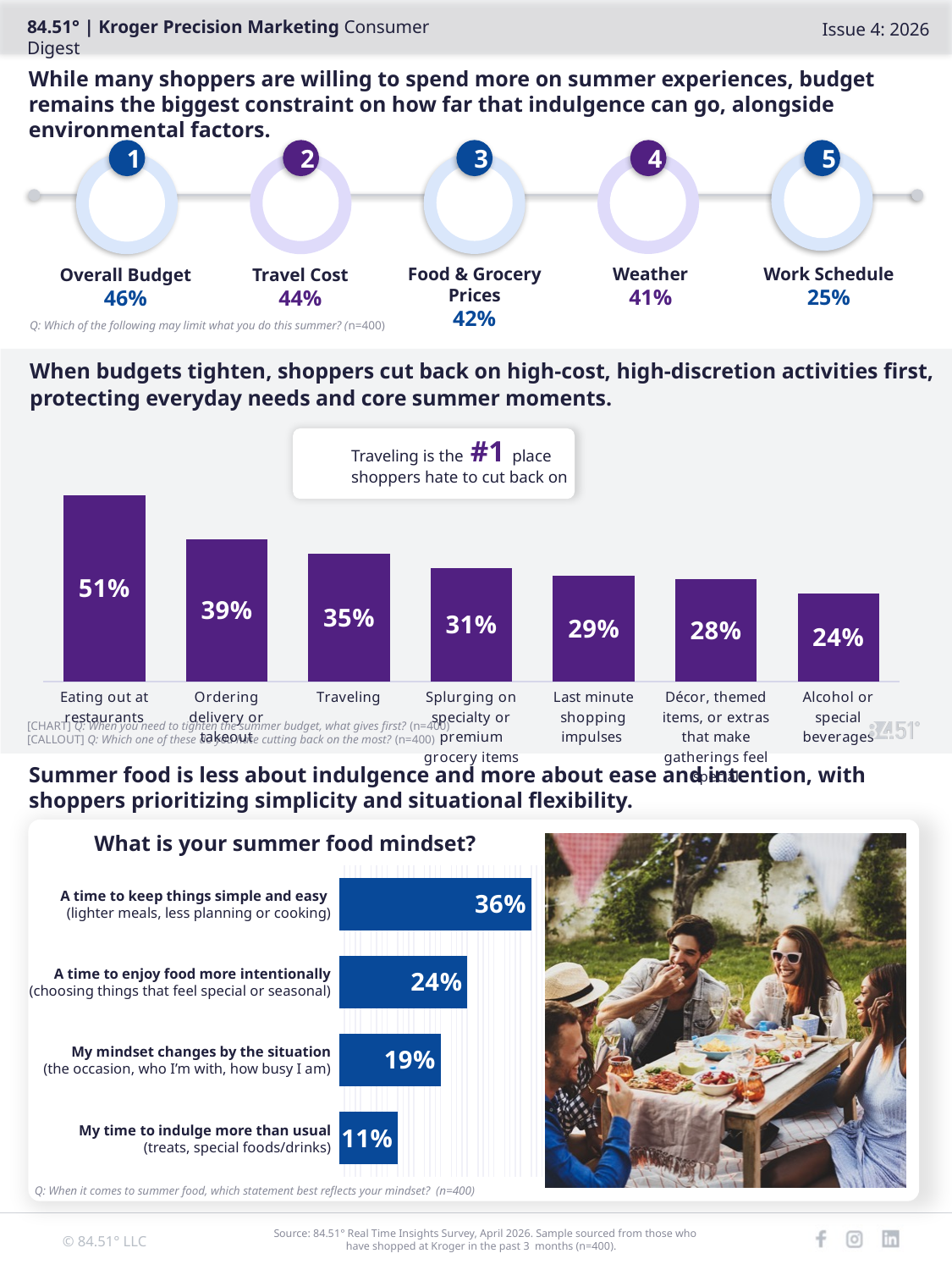
In the middle bar chart about what shoppers cut back on first, do the values rise or fall from left to right? Fall In the 'What is your summer food mindset?' chart, what is the value for 'A time to keep things simple and easy'? 36% In the middle bar chart about what shoppers cut back on first, how many categories are shown? 7 In the middle bar chart about what shoppers cut back on first, what is the value for Traveling? 35% What type of chart is the 'What is your summer food mindset?' chart? Bar chart In the middle bar chart about what shoppers cut back on first, which category has the lowest value? Alcohol or special beverages In the middle bar chart about what shoppers cut back on first, what is the value for Eating out at restaurants? 51% In the 'What is your summer food mindset?' chart, how many categories are shown? 4 In the middle bar chart about what shoppers cut back on first, which category has the highest value? Eating out at restaurants In the 'What is your summer food mindset?' chart, which is larger: 'A time to enjoy food more intentionally' or 'My mindset changes by the situation'? A time to enjoy food more intentionally In the 'What is your summer food mindset?' chart, what is the value for 'My time to indulge more than usual'? 11% In the middle bar chart about what shoppers cut back on first, what is the difference between Eating out at restaurants and Ordering delivery or takeout? 12 percentage points